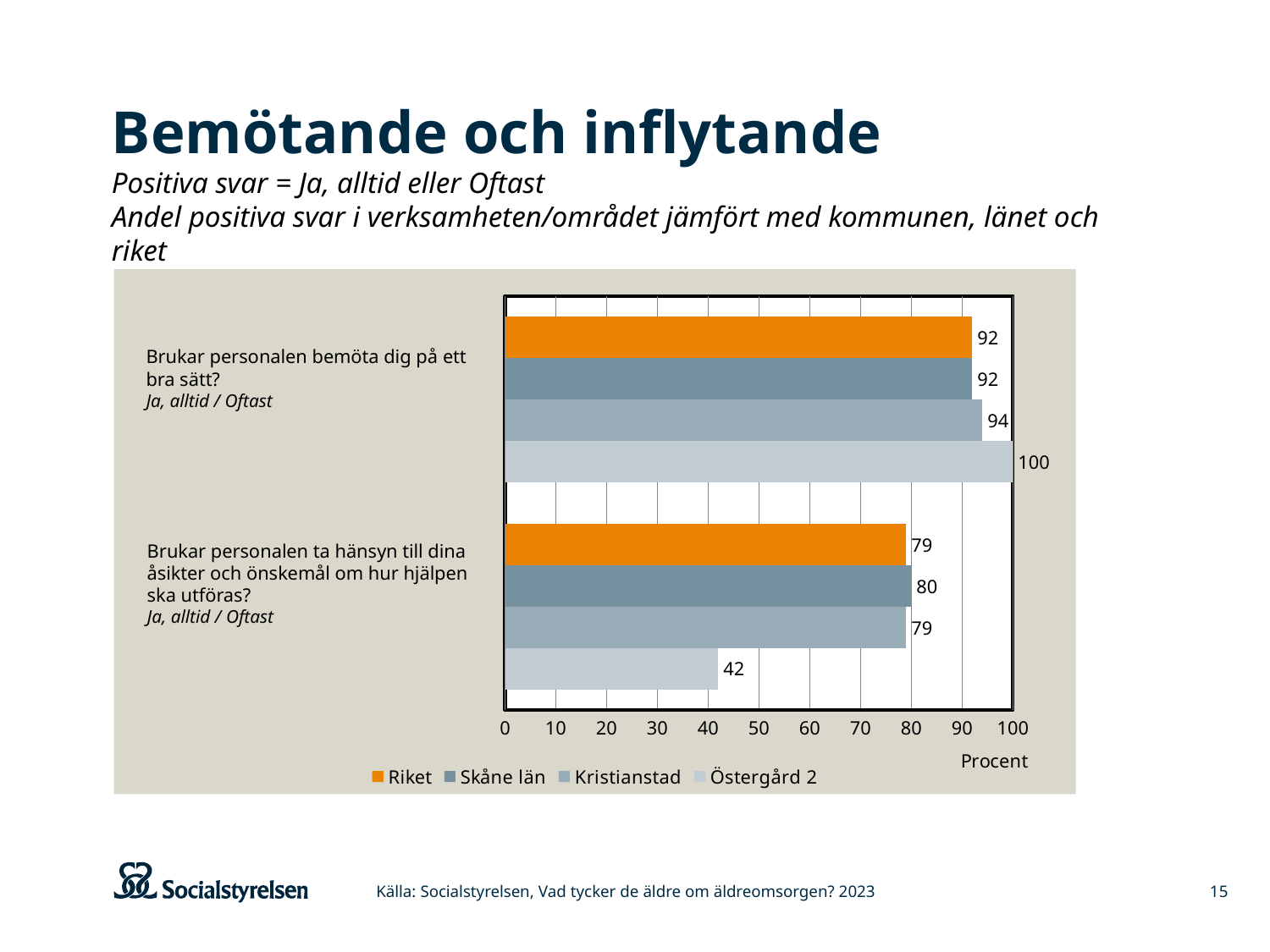
Which series has the lowest value for the question "Brukar personalen ta hänsyn till dina åsikter och önskemål om hur hjälpen ska utföras?"? Östergård 2 What is the value for Östergård 2 for the question "Brukar personalen ta hänsyn till dina åsikter och önskemål om hur hjälpen ska utföras?"? 42 What is the difference between the Östergård 2 values for the two questions? 58 What kind of chart is shown on the slide? bar chart How many questions (categories) are shown on the chart? 2 Which series has the highest value for the question "Brukar personalen bemöta dig på ett bra sätt?"? Östergård 2 How many series does the legend list? 4 What is the value for Östergård 2 for the question "Brukar personalen bemöta dig på ett bra sätt?"? 100 What is the value for Kristianstad for the question "Brukar personalen bemöta dig på ett bra sätt?"? 94 What is the value for Riket for the question "Brukar personalen ta hänsyn till dina åsikter och önskemål om hur hjälpen ska utföras?"? 79 Which is larger for the question "Brukar personalen ta hänsyn till dina åsikter och önskemål om hur hjälpen ska utföras?": Skåne län or Östergård 2? Skåne län What is the label on the horizontal axis? Procent